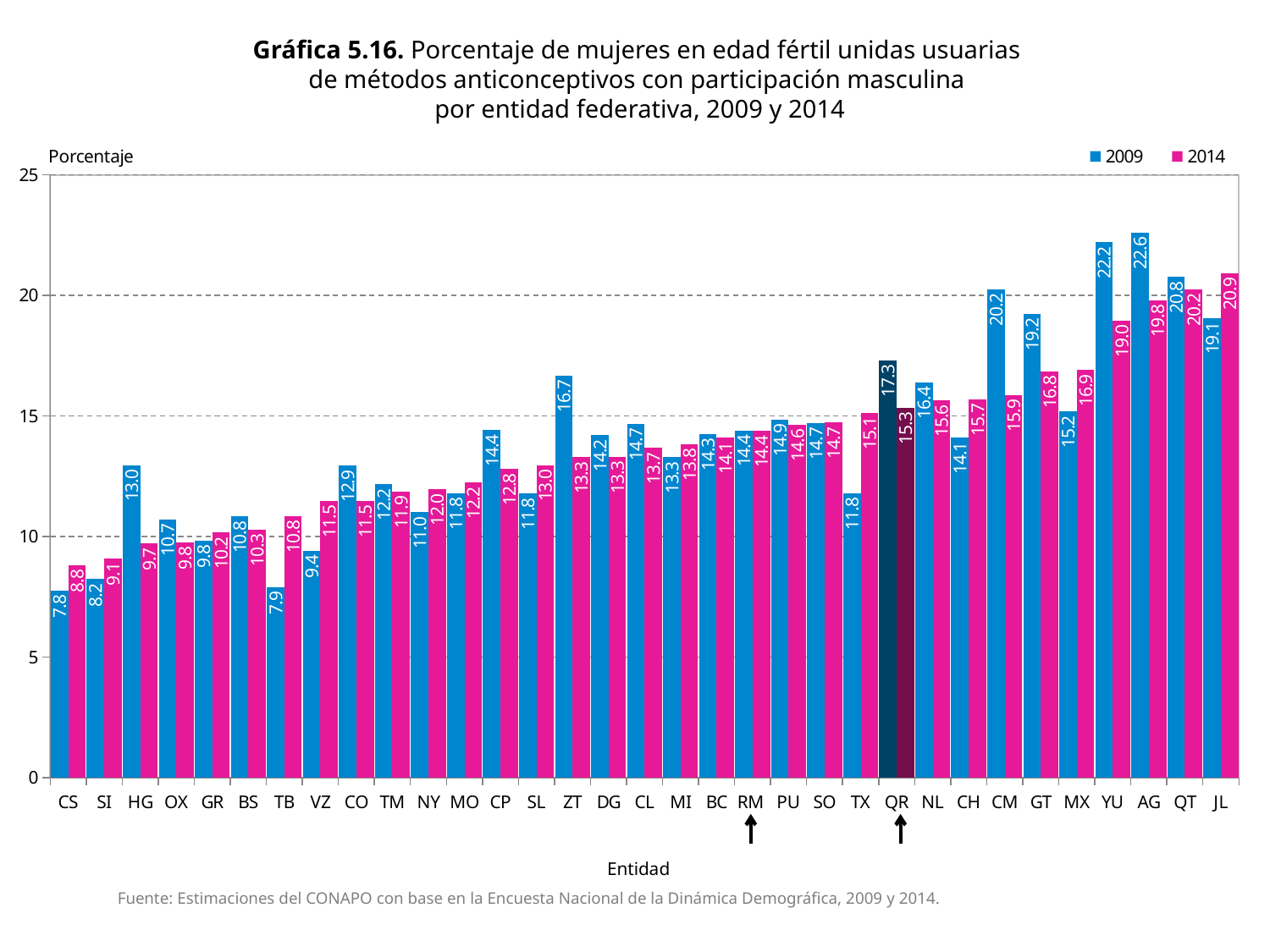
What is the difference between the 2009 and 2014 values for CM? 4.3 What is the 2009 value for TX? 11.8 Which entity has the highest 2014 value? JL Which series is shown in blue? 2009 What is the 2009 value for AG? 22.6 What kind of chart is this? bar chart What is the 2014 value for QR? 15.3 How many entities are shown on the x axis? 33 Which entity has the lowest 2009 value? CS Which is larger for HG, the 2009 value or the 2014 value? 2009 How many series does the legend list? 2 Is the 2014 value for YU greater or less than 20? less